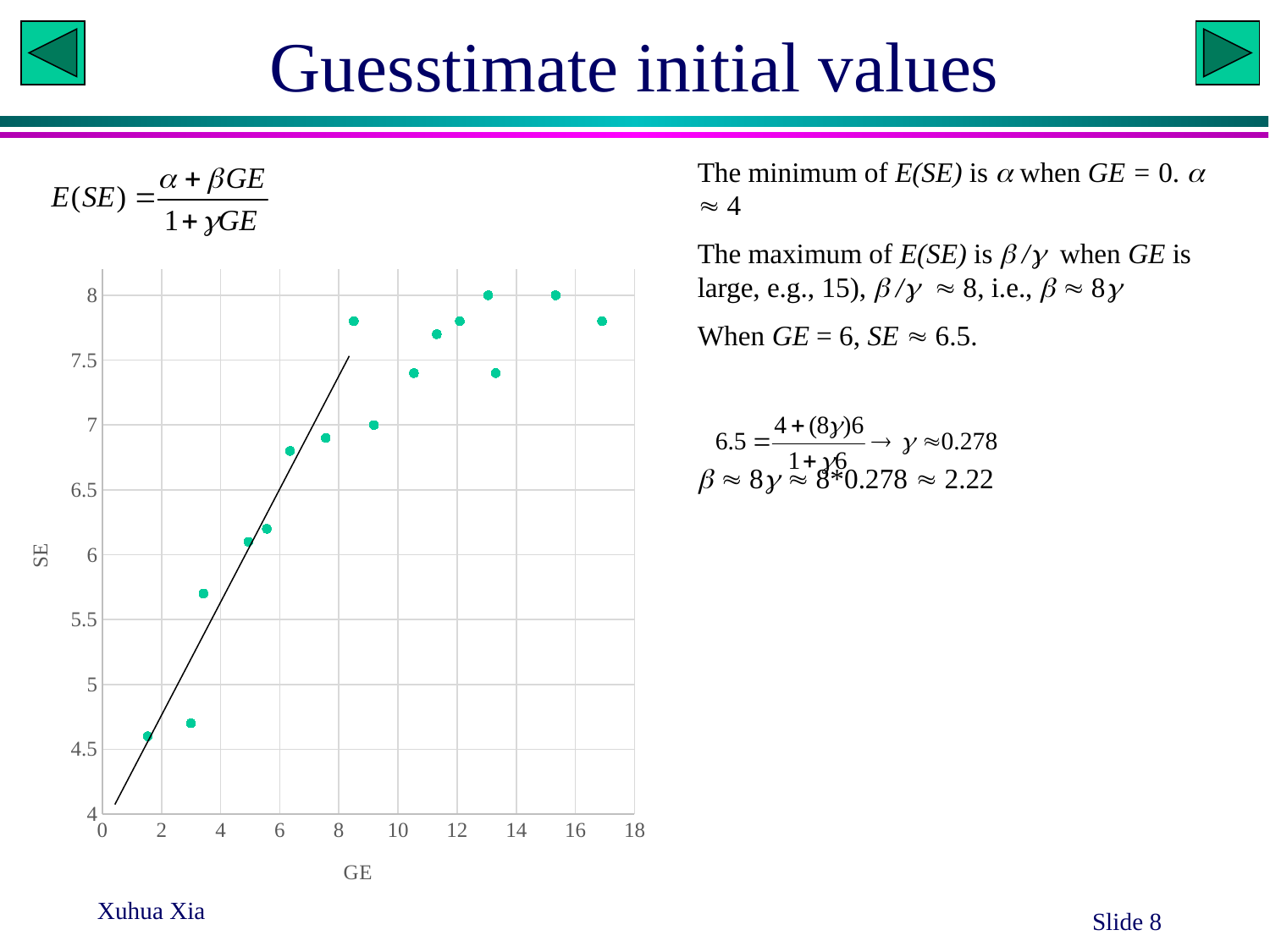
How many data points are plotted in the chart? 16 Do the SE values generally rise or fall as GE increases along the x axis? rise What is the highest tick value shown on the x axis of the chart? 18 Is the SE value for the point at GE of about 6.4 greater or less than 6.5? greater What kind of chart is shown on the slide? scatter plot Is the SE value for the point at GE of about 1.5 greater or less than 5? less What is the label of the y axis of the chart? SE Is the SE value for the point at GE of about 3 greater or less than 5? less Which has the larger SE value: the point at GE of about 1.5 or the point at GE of about 15? the point at GE of about 15 What is the label of the x axis of the chart? GE